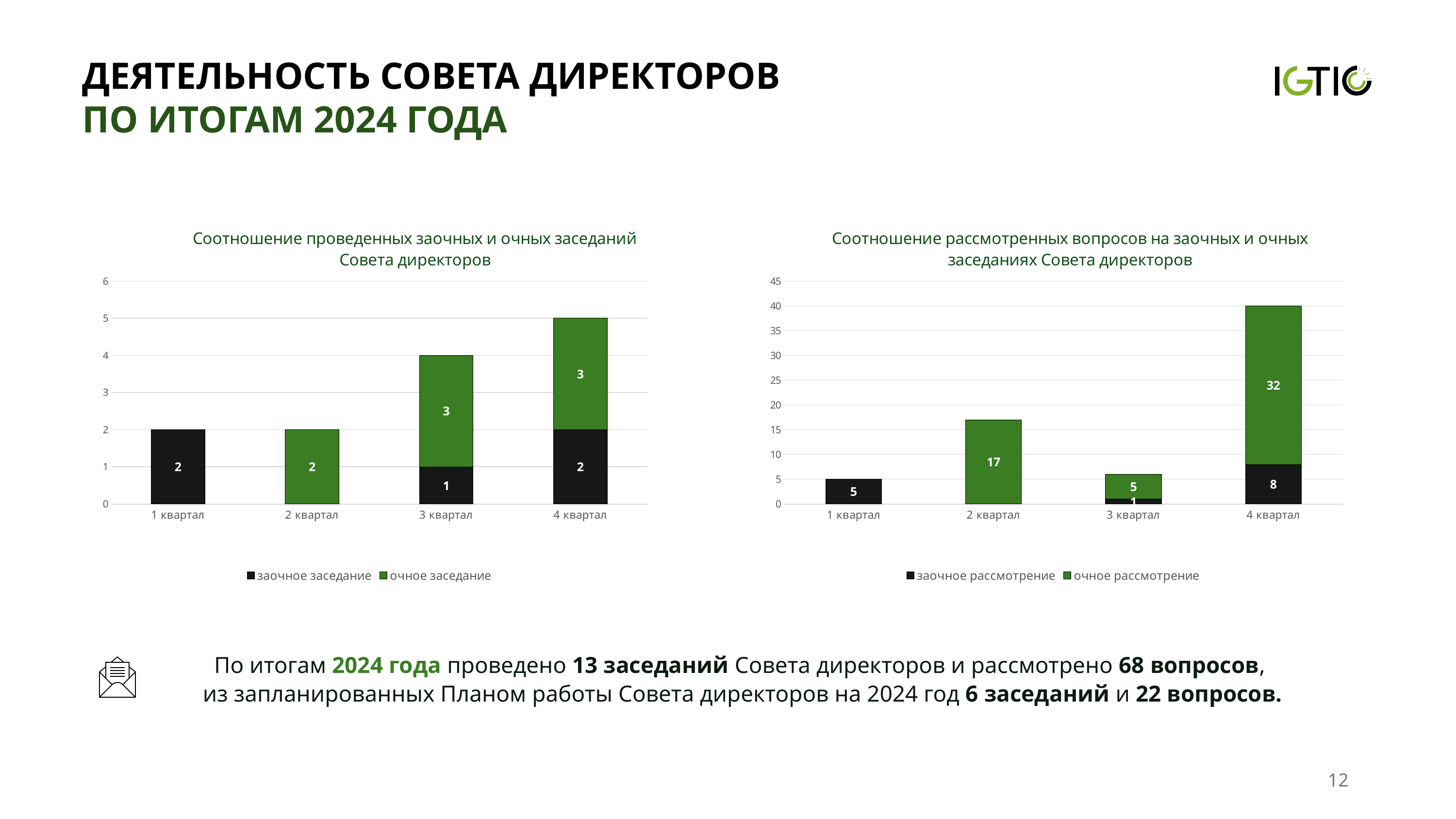
In the right chart (Соотношение рассмотренных вопросов на заочных и очных заседаниях Совета директоров), what is the difference between очное рассмотрение in 2 квартал and очное рассмотрение in 3 квартал? 12 In the left chart (Соотношение проведенных заочных и очных заседаний Совета директоров), how many series does the legend list? 2 In the left chart (Соотношение проведенных заочных и очных заседаний Совета директоров), what is the value for очное заседание in 3 квартал? 3 In the right chart (Соотношение рассмотренных вопросов на заочных и очных заседаниях Совета директоров), what is the total of the stacked bar for 4 квартал? 40 In the right chart (Соотношение рассмотренных вопросов на заочных и очных заседаниях Совета директоров), what is the value for заочное рассмотрение in 1 квартал? 5 In the right chart (Соотношение рассмотренных вопросов на заочных и очных заседаниях Совета директоров), what is the value for очное рассмотрение in 4 квартал? 32 In the left chart (Соотношение проведенных заочных и очных заседаний Совета директоров), what is the total height of the stacked bar for 4 квартал? 5 In the left chart (Соотношение проведенных заочных и очных заседаний Совета директоров), what kind of chart is shown? Stacked bar chart In the left chart (Соотношение проведенных заочных и очных заседаний Совета директоров), what is the value for заочное заседание in 4 квартал? 2 In the right chart (Соотношение рассмотренных вопросов на заочных и очных заседаниях Совета директоров), how many quarters are shown on the x axis? 4 In the right chart (Соотношение рассмотренных вопросов на заочных и очных заседаниях Совета директоров), which colour represents заочное рассмотрение? Black In the right chart (Соотношение рассмотренных вопросов на заочных и очных заседаниях Совета директоров), which quarter has the highest total stacked bar? 4 квартал